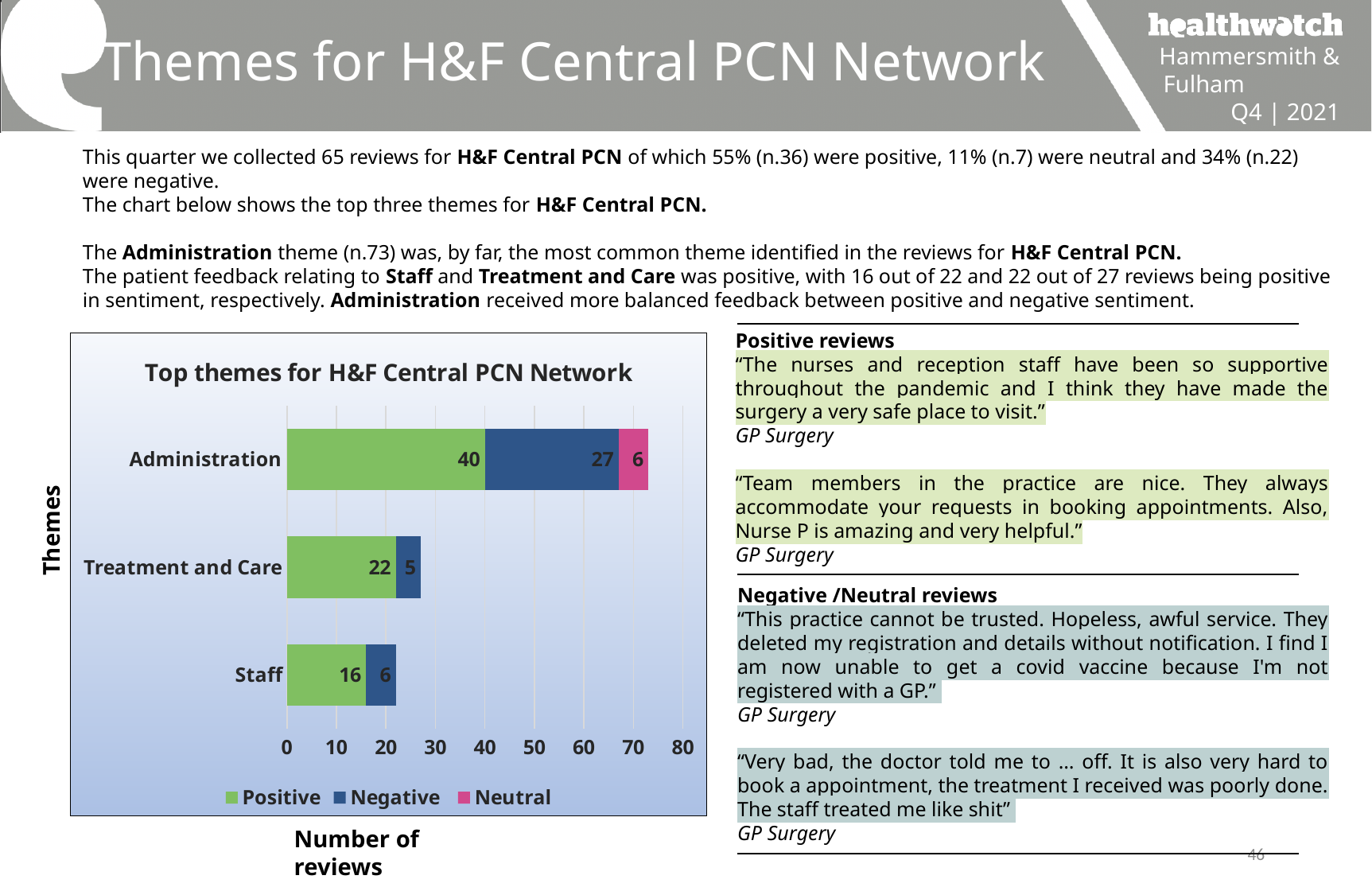
How many series does the legend list? 3 What kind of chart is shown? Bar chart Which theme has the lowest Negative value? Treatment and Care What is the total of the stacked bar for Administration? 73 What is the Positive value for Administration? 40 What is the difference between the Positive and Negative values for Administration? 13 What is the Positive value for Staff? 16 How many themes are shown on the chart? 3 What is the Negative value for Treatment and Care? 5 Which is larger, the Positive value for Treatment and Care or the Positive value for Staff? Treatment and Care Which theme has the highest Positive value? Administration What is the Neutral value for Administration? 6